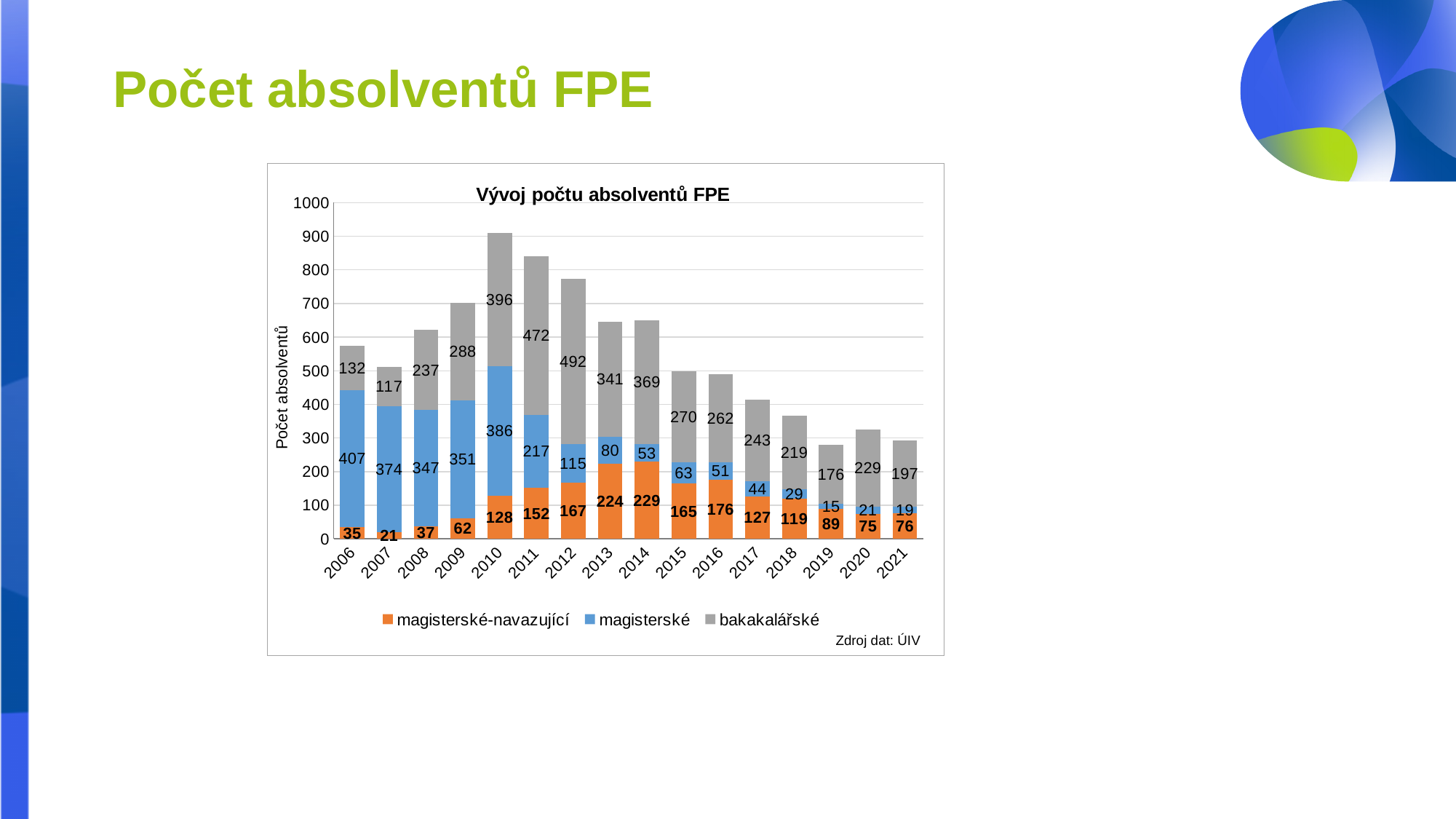
In which year is the bakalářské value highest? 2012 What is the total of the stacked bar for 2010? 910 What is the value for bakalářské in 2012? 492 Which is larger, the bakalářské value in 2010 or in 2011? 2011 What is the title of the chart? Vývoj počtu absolventů FPE How many years are shown on the x axis? 16 What type of chart is shown on the slide? stacked bar chart What is the difference between the magisterské values in 2006 and 2007? 33 What is the value for magisterské-navazující in 2019? 89 How many series does the legend list? 3 In which year is the magisterské value lowest? 2019 What is the value for magisterské in 2010? 386